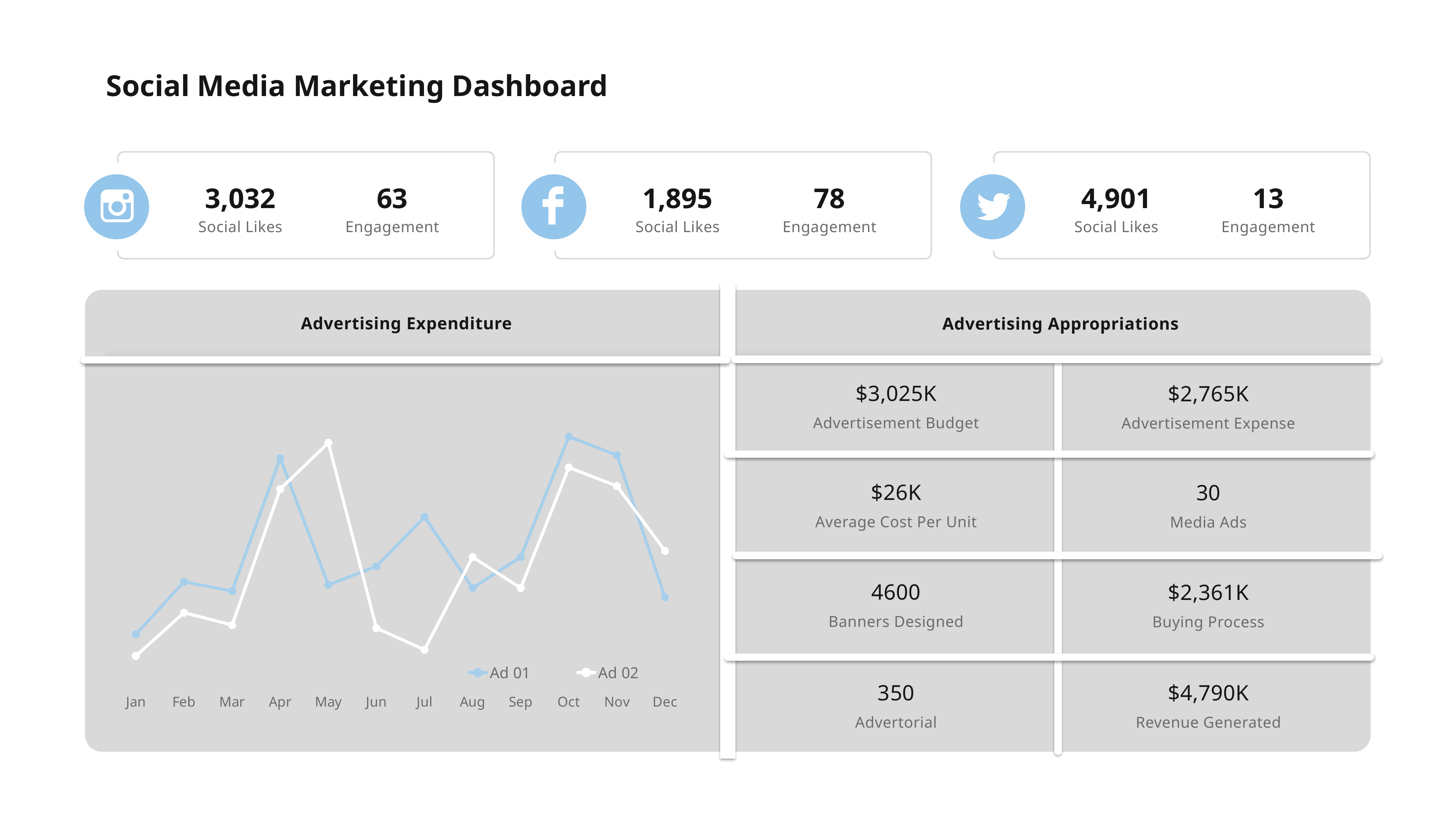
How many months are shown on the x axis of the Advertising Expenditure chart? 12 In the Advertising Expenditure chart, in which month does Ad 01 have its lowest value? Jan What kind of chart is the Advertising Expenditure chart? line chart In the Advertising Expenditure chart, which series is higher in Apr, Ad 01 or Ad 02? Ad 01 In the Advertising Expenditure chart, which series is higher in May, Ad 01 or Ad 02? Ad 02 In the Advertising Expenditure chart, does Ad 01 rise or fall from Sep to Oct? rise In the Advertising Expenditure chart, in which month does Ad 02 reach its highest value? May In the Advertising Expenditure chart, does Ad 02 rise or fall from May to Jun? fall In the Advertising Expenditure chart, which series is higher in Dec, Ad 01 or Ad 02? Ad 02 What are the two legend entries of the Advertising Expenditure chart? Ad 01 and Ad 02 In the Advertising Expenditure chart, in which month does Ad 01 reach its highest value? Oct How many series does the legend of the Advertising Expenditure chart list? 2